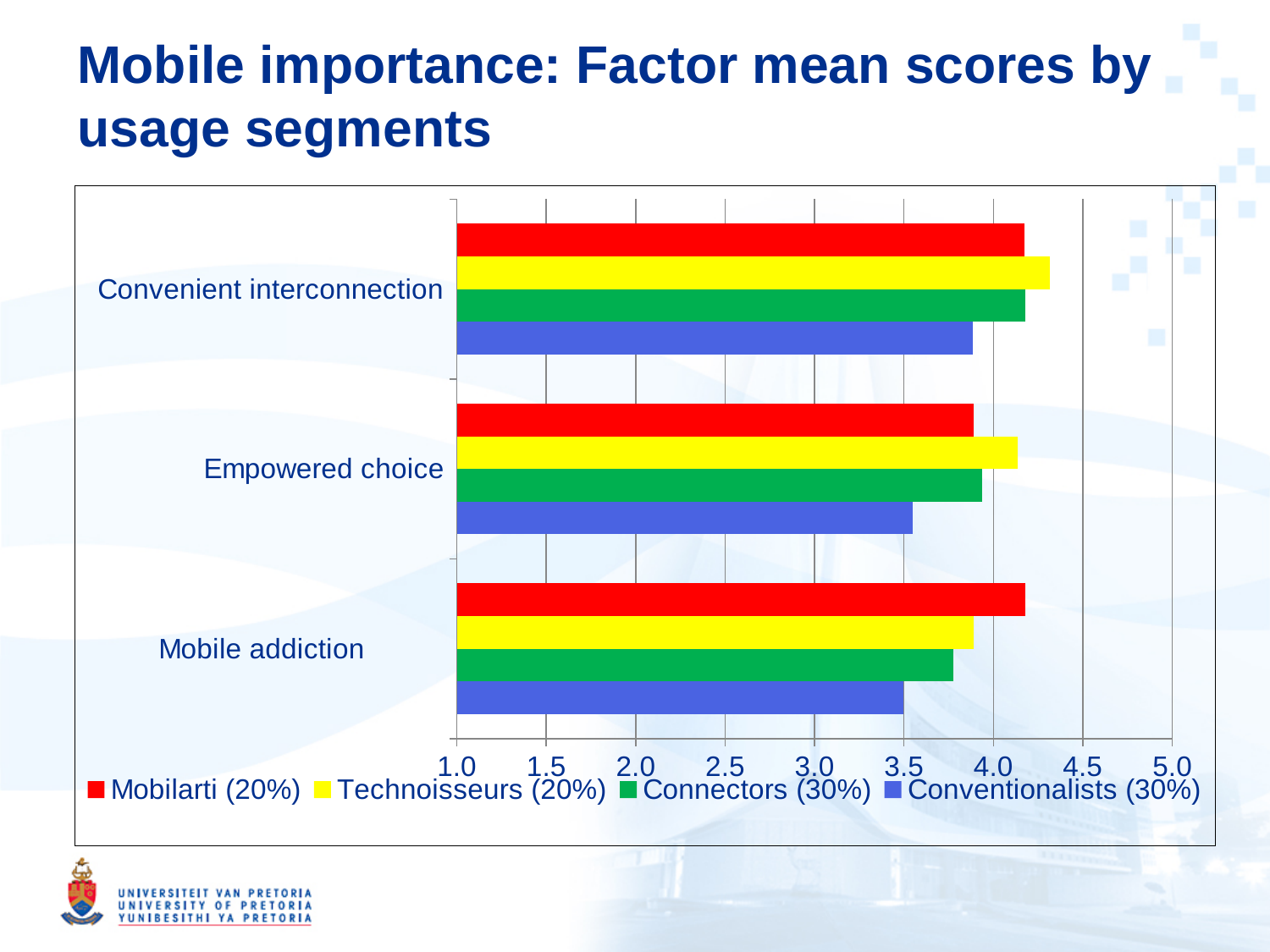
For Mobile addiction, which is larger: the Mobilarti value or the Conventionalists value? Mobilarti (20%) Which usage segment has the highest mean score for Convenient interconnection? Technoisseurs (20%) How many series does the legend list? 4 What kind of chart is shown on the slide? Bar chart Is the Technoisseurs value for Convenient interconnection greater or less than 4.0? greater Is the Connectors value for Mobile addiction greater or less than 4.0? less Is the Conventionalists value for Empowered choice greater or less than 4.0? less Which usage segment has the lowest mean score for Mobile addiction? Conventionalists (30%) Which usage segment has the lowest mean score for Empowered choice? Conventionalists (30%) What colour represents the Connectors (30%) series in the chart? Green How many factor categories are shown on the chart? 3 Which usage segment has the highest mean score for Mobile addiction? Mobilarti (20%)